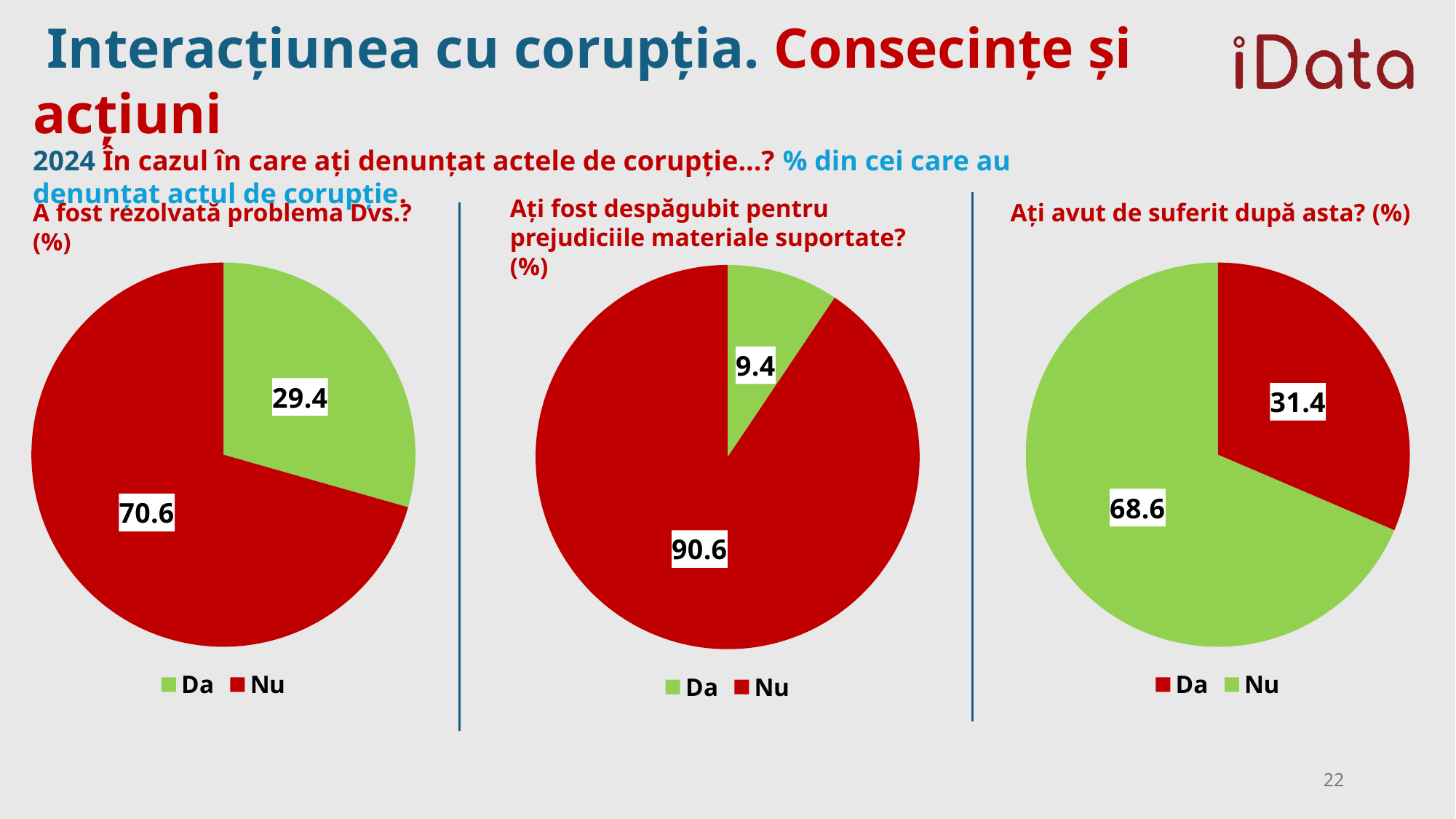
In the left chart 'A fost rezolvată problema Dvs.? (%)', what is the difference between the 'Nu' and 'Da' values? 41.2 In the right chart 'Ați avut de suferit după asta? (%)', which is larger, 'Da' or 'Nu'? Nu In the middle chart 'Ați fost despăgubit pentru prejudiciile materiale suportate? (%)', what is the value for 'Nu'? 90.6 In the left chart 'A fost rezolvată problema Dvs.? (%)', what is the value for 'Da'? 29.4 In the left chart 'A fost rezolvată problema Dvs.? (%)', what is the value for 'Nu'? 70.6 In the right chart 'Ați avut de suferit după asta? (%)', which category has the largest slice? Nu In the middle chart 'Ați fost despăgubit pentru prejudiciile materiale suportate? (%)', what is the value for 'Da'? 9.4 In the middle chart 'Ați fost despăgubit pentru prejudiciile materiale suportate? (%)', which category has the smallest slice? Da In the right chart 'Ați avut de suferit după asta? (%)', what is the value for 'Da'? 31.4 How many categories does the legend of the middle chart 'Ați fost despăgubit pentru prejudiciile materiale suportate? (%)' list? 2 What type of chart is used for 'A fost rezolvată problema Dvs.? (%)'? Pie chart In the right chart 'Ați avut de suferit după asta? (%)', what is the value for 'Nu'? 68.6